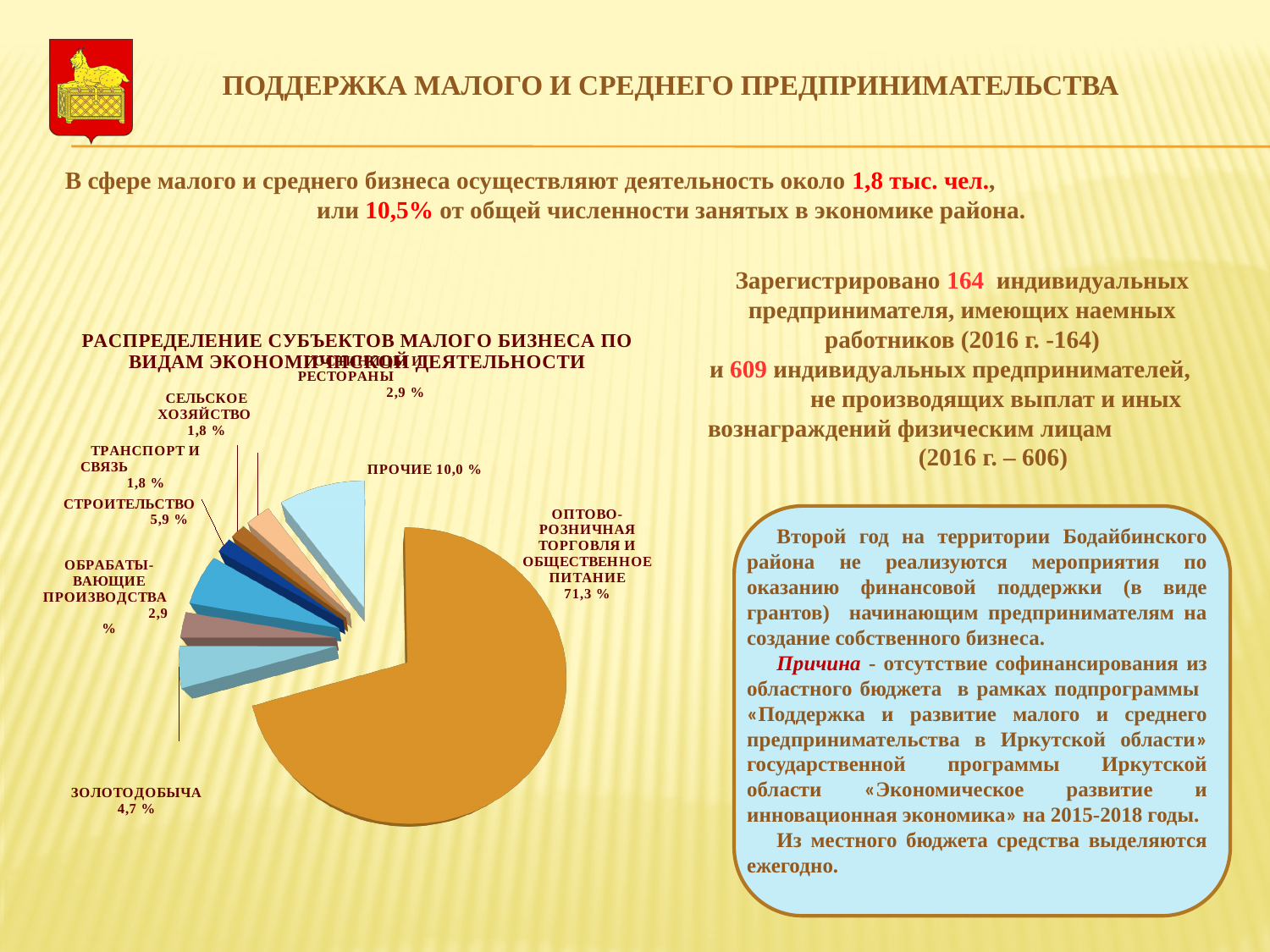
What share of small business entities is in оптово-розничная торговля и общественное питание? 71,3 % What share is shown for прочие? 10,0 % How many slices does the pie chart have? 8 What share of small business entities is in строительство? 5,9 % What kind of chart is shown on the slide? pie chart What is the difference between the share for прочие and the share for золотодобыча? 5,3 % What share is shown for транспорт и связь? 1,8 % What share of small business entities is in золотодобыча? 4,7 % Which category has the largest share of the pie? Оптово-розничная торговля и общественное питание What share is shown for обрабатывающие производства? 2,9 % What is the title of the pie chart? Распределение субъектов малого бизнеса по видам экономической деятельности Which is larger: the share for строительство or the share for золотодобыча? Строительство